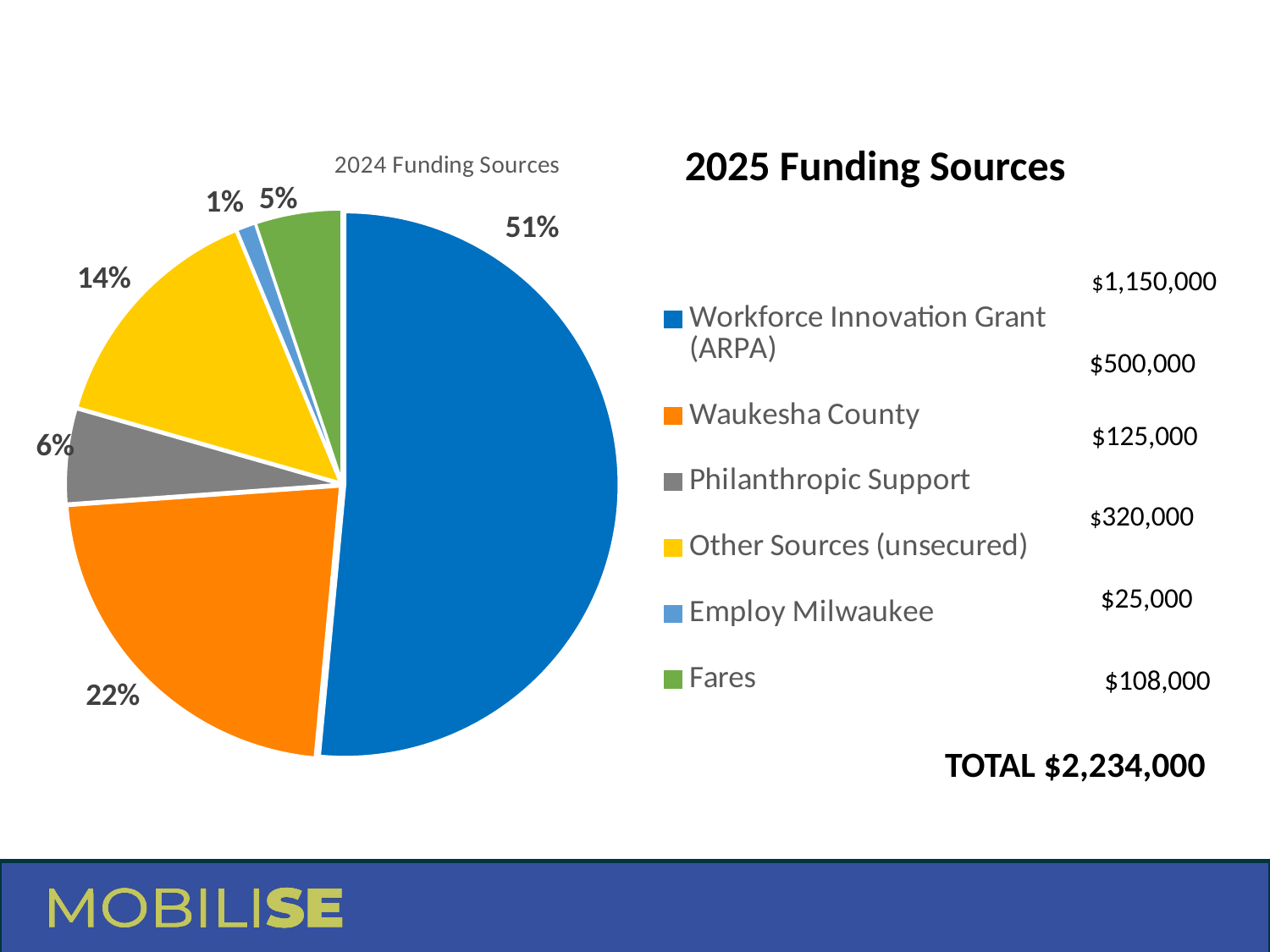
What is the difference in percentage points between the Waukesha County slice and the Other Sources (unsecured) slice? 8 What share of the pie does Fares represent? 5% What is the title of the pie chart? 2024 Funding Sources Which funding source has the smallest slice of the pie? Employ Milwaukee What share of the pie does Other Sources (unsecured) represent? 14% Which funding source has the largest slice of the pie? Workforce Innovation Grant (ARPA) What share of the pie does Workforce Innovation Grant (ARPA) represent? 51% Which slice is larger, Philanthropic Support or Fares? Philanthropic Support How many slices does the pie chart have? 6 What kind of chart is shown on the slide? pie chart